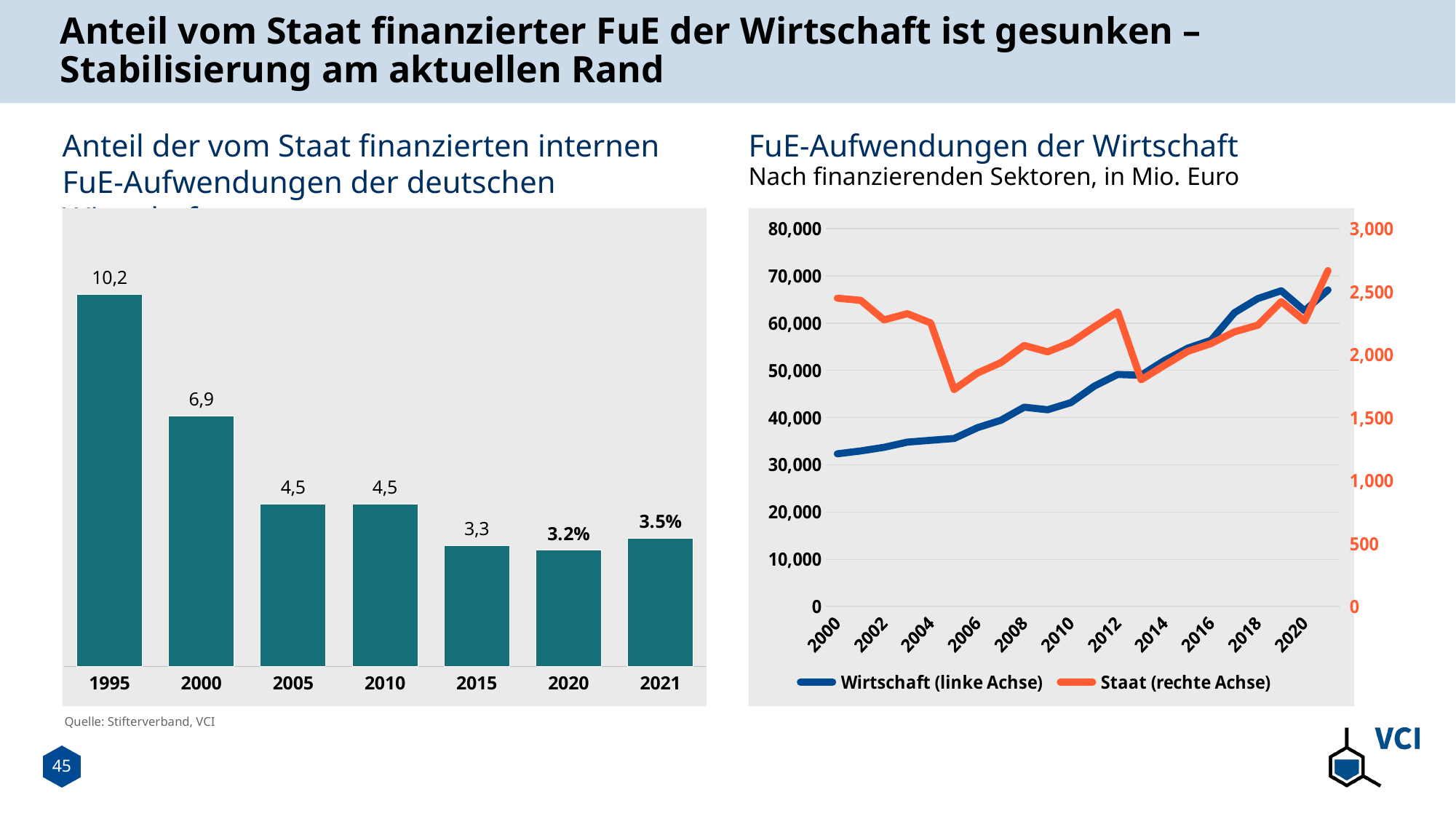
In the chart 'FuE-Aufwendungen der Wirtschaft', which axis does the Staat series use according to the legend? rechte Achse What kind of chart is the chart titled 'FuE-Aufwendungen der Wirtschaft'? line chart In the chart 'FuE-Aufwendungen der Wirtschaft', is the value for Wirtschaft in 2000 greater or less than 40,000? less In the left bar chart, which year has the lowest value? 2020 How many bars are shown in the left bar chart? 7 In the chart 'FuE-Aufwendungen der Wirtschaft', does the Wirtschaft series generally rise or fall from 2000 to 2021? rise How many series does the legend of the chart 'FuE-Aufwendungen der Wirtschaft' list? 2 In the left bar chart, what is the difference between the values for 1995 and 2000? 3,3 In the left bar chart, which is larger, the value for 2015 or the value for 2021? 2021 In the left bar chart, what is the value for 1995? 10,2 In the left bar chart, what is the value for 2021? 3.5% In the left bar chart, which year has the highest value? 1995